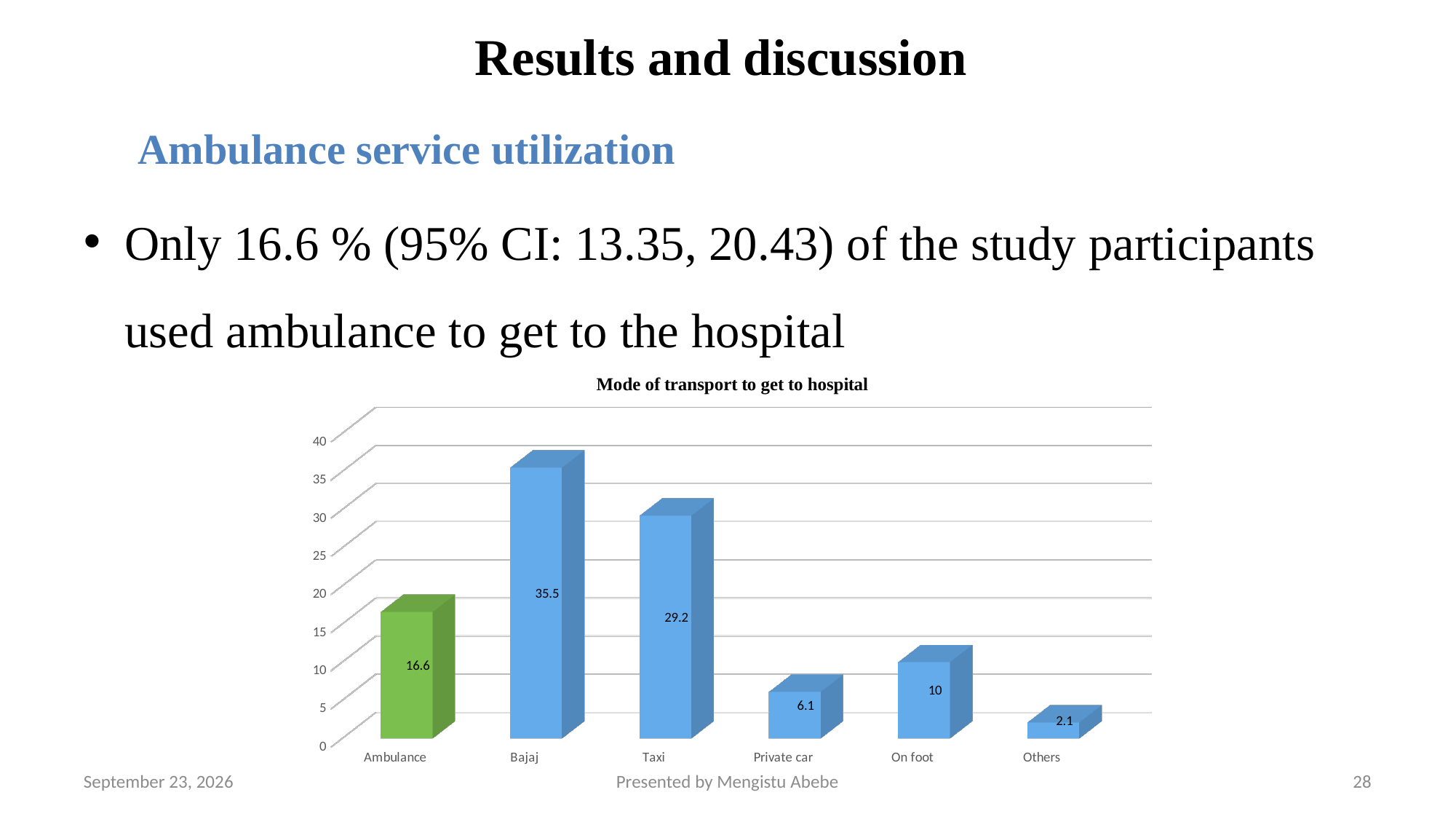
Which is larger, the value for Ambulance or the value for Private car? Ambulance What is the value for Taxi in the chart? 29.2 What is the value for On foot in the chart? 10 What is the value for Private car in the chart? 6.1 How many modes of transport are shown in the chart? 6 What is the value for Bajaj in the chart? 35.5 What is the difference between the values for Ambulance and On foot? 6.6 Which mode of transport has the lowest value? Others What kind of chart is shown on the slide? Bar chart What is the difference between the values for Bajaj and Taxi? 6.3 What is the title of the chart? Mode of transport to get to hospital Which mode of transport has the highest value? Bajaj